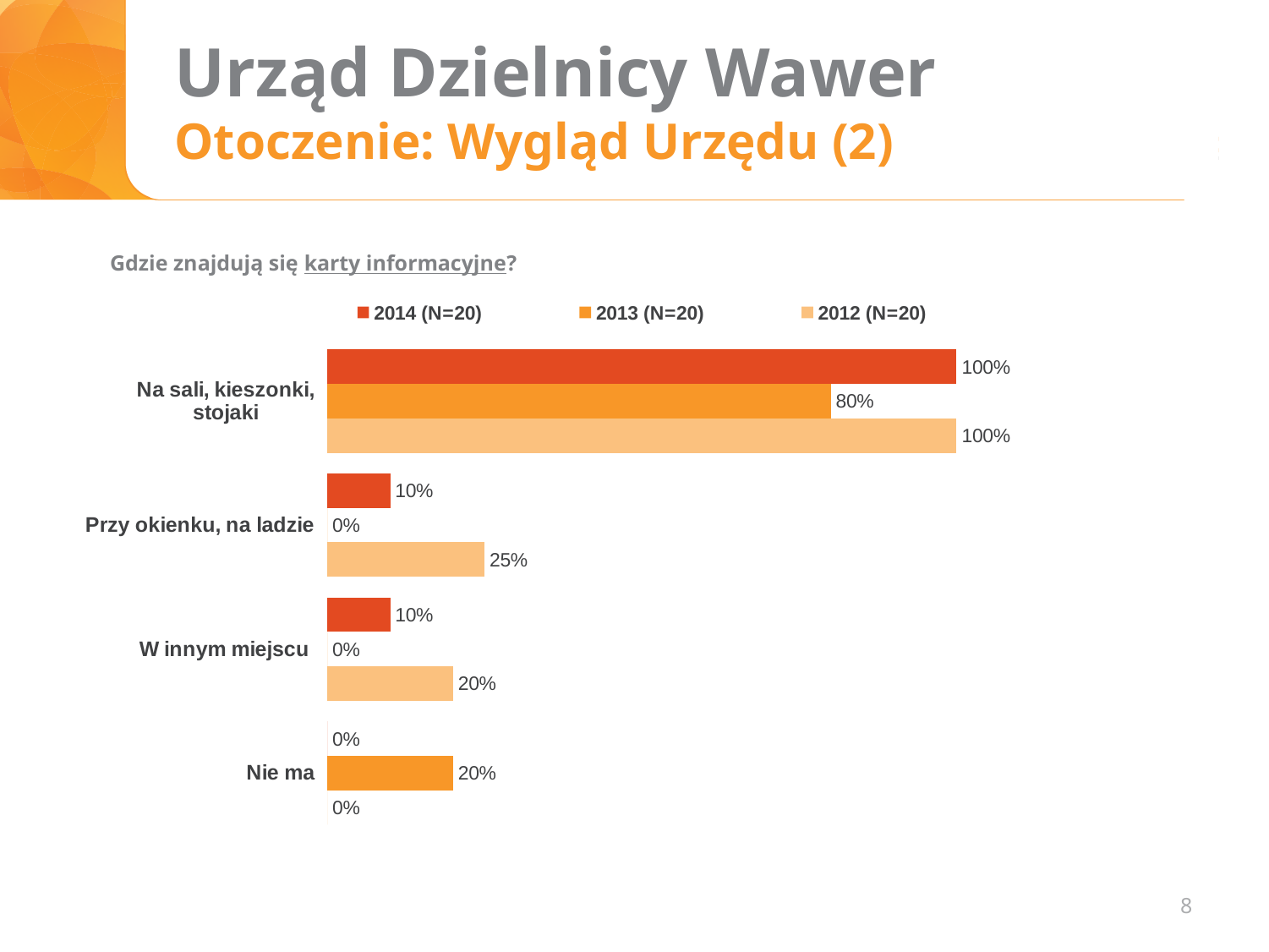
What kind of chart is shown on the slide? Bar chart How many categories are shown on the chart? 4 What is the value for 'W innym miejscu' in the 2014 (N=20) series? 10% Which category has the highest value in the 2014 (N=20) series? Na sali, kieszonki, stojaki Which category has the lowest value in the 2012 (N=20) series? Nie ma What is the value for 'Na sali, kieszonki, stojaki' in the 2013 (N=20) series? 80% What is the value for 'Przy okienku, na ladzie' in the 2012 (N=20) series? 25% What question does the chart answer, as written above it? Gdzie znajdują się karty informacyjne? How many series does the legend list? 3 Which is larger for 'W innym miejscu': the 2012 (N=20) value or the 2014 (N=20) value? 2012 (N=20) What is the value for 'Nie ma' in the 2013 (N=20) series? 20% What is the difference between the 2012 (N=20) and 2014 (N=20) values for 'Przy okienku, na ladzie'? 15%